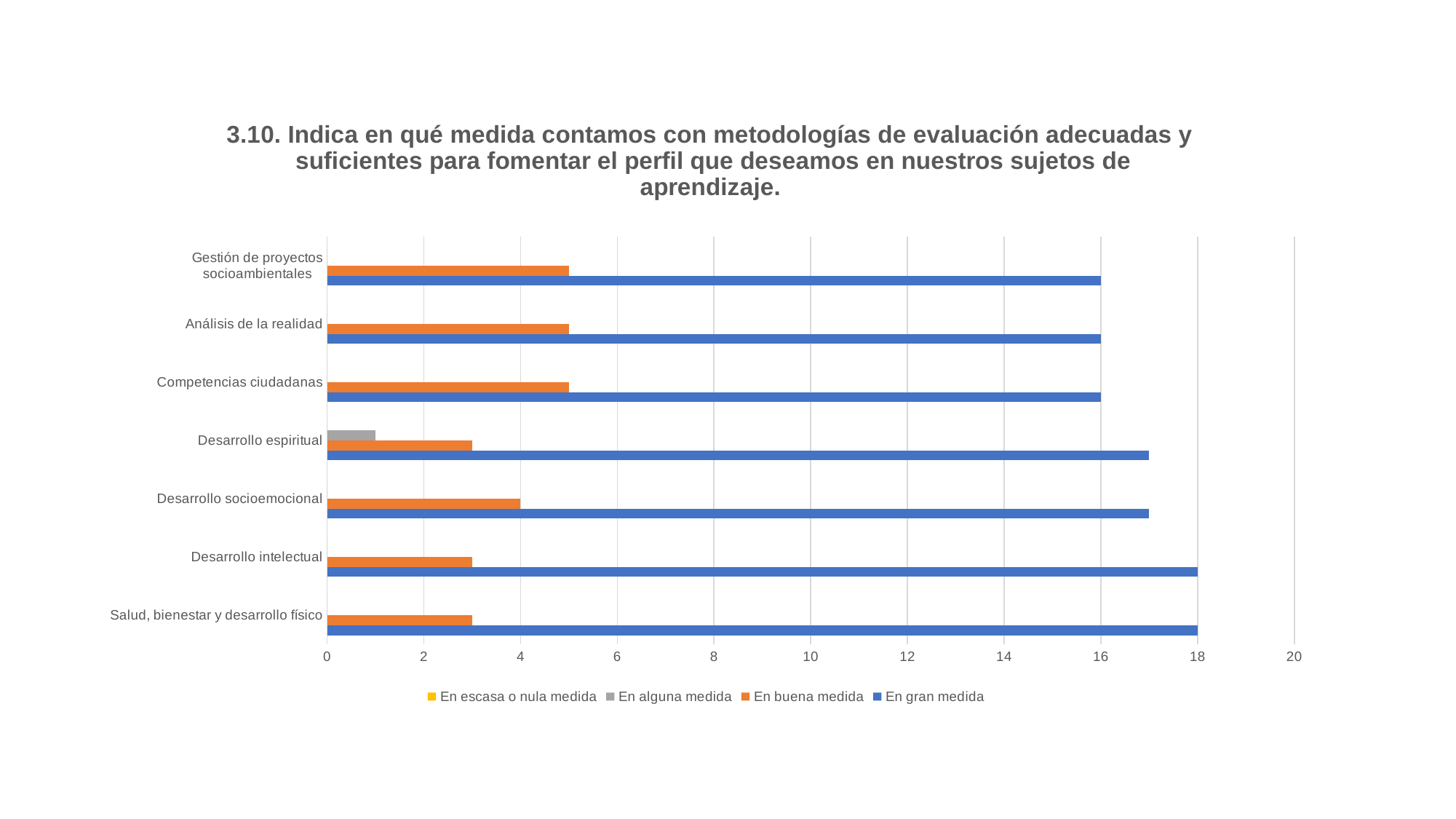
What is the value of 'En gran medida' for 'Desarrollo intelectual'? 18 Is the 'En buena medida' value for 'Desarrollo intelectual' greater or less than 4? less What is the difference between the 'En gran medida' values for 'Salud, bienestar y desarrollo físico' and 'Análisis de la realidad'? 2 How many categories are listed on the vertical axis of the chart? 7 What type of chart is shown on the slide? bar chart What is the value of 'En gran medida' for 'Gestión de proyectos socioambientales'? 16 Which category is the only one with a visible 'En alguna medida' bar? Desarrollo espiritual Which has a larger 'En gran medida' value: 'Desarrollo intelectual' or 'Competencias ciudadanas'? Desarrollo intelectual Is the 'En gran medida' value for 'Desarrollo espiritual' greater or less than 16? greater Is the 'En buena medida' value for 'Competencias ciudadanas' greater or less than 4? greater How many series does the legend list? 4 What is the value of 'En buena medida' for 'Desarrollo socioemocional'? 4